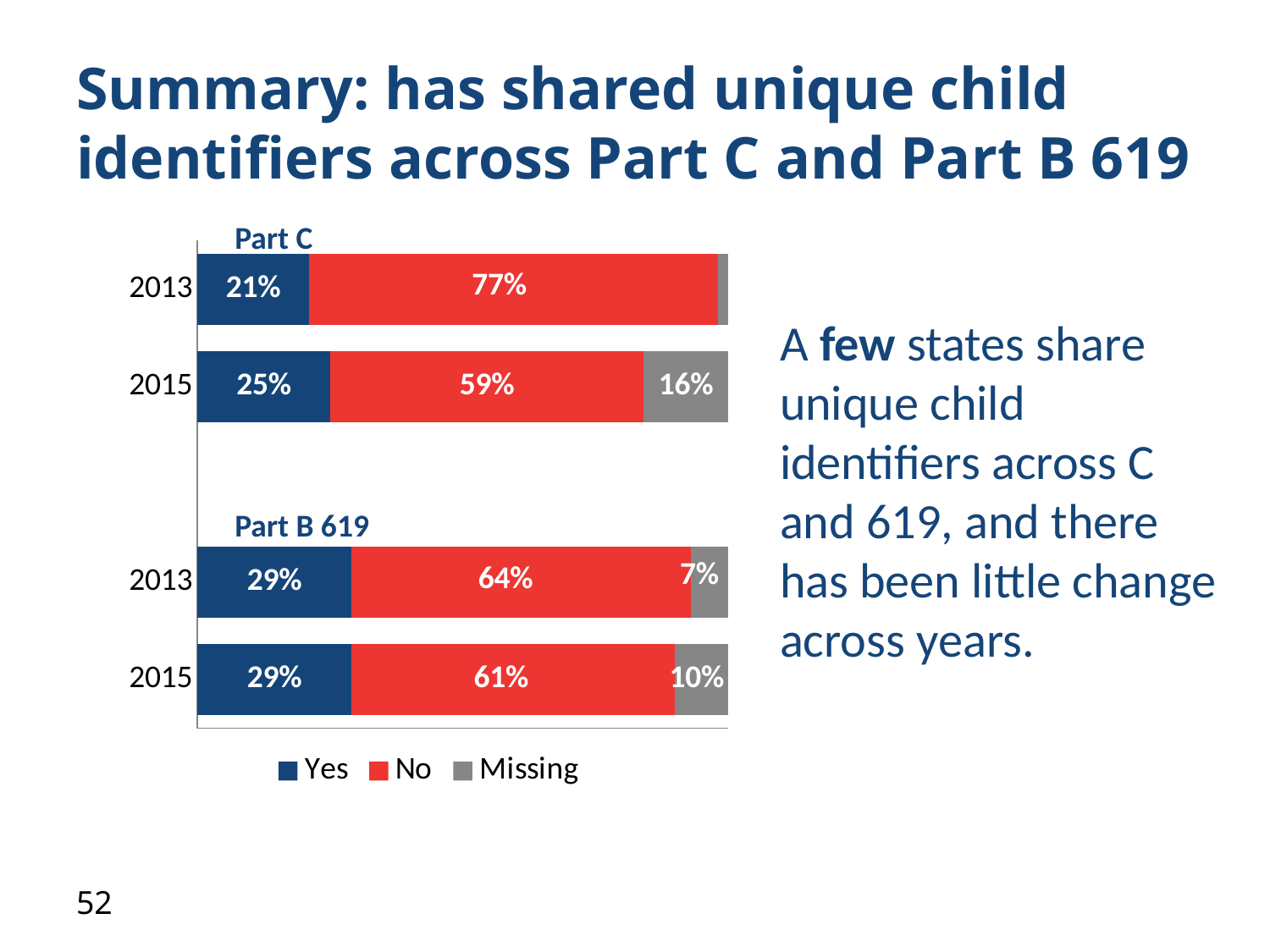
What is the difference between the No percentage for Part C in 2013 and in 2015? 18% How many series does the legend list? 3 What is the Yes percentage for Part B 619 in 2013? 29% How many bars are plotted in the chart? 4 Which bar has the lowest Yes percentage? Part C 2013 Which bar has the highest No percentage? Part C 2013 Which colour represents the No series in the chart? Red What kind of chart is shown on the slide? Stacked bar chart What percentage of states answered Yes for Part C in 2013? 21% Is the Missing percentage larger for Part C 2015 or Part B 619 2015? Part C 2015 What percentage of states answered No for Part C in 2015? 59% What is the Missing percentage for Part B 619 in 2015? 10%